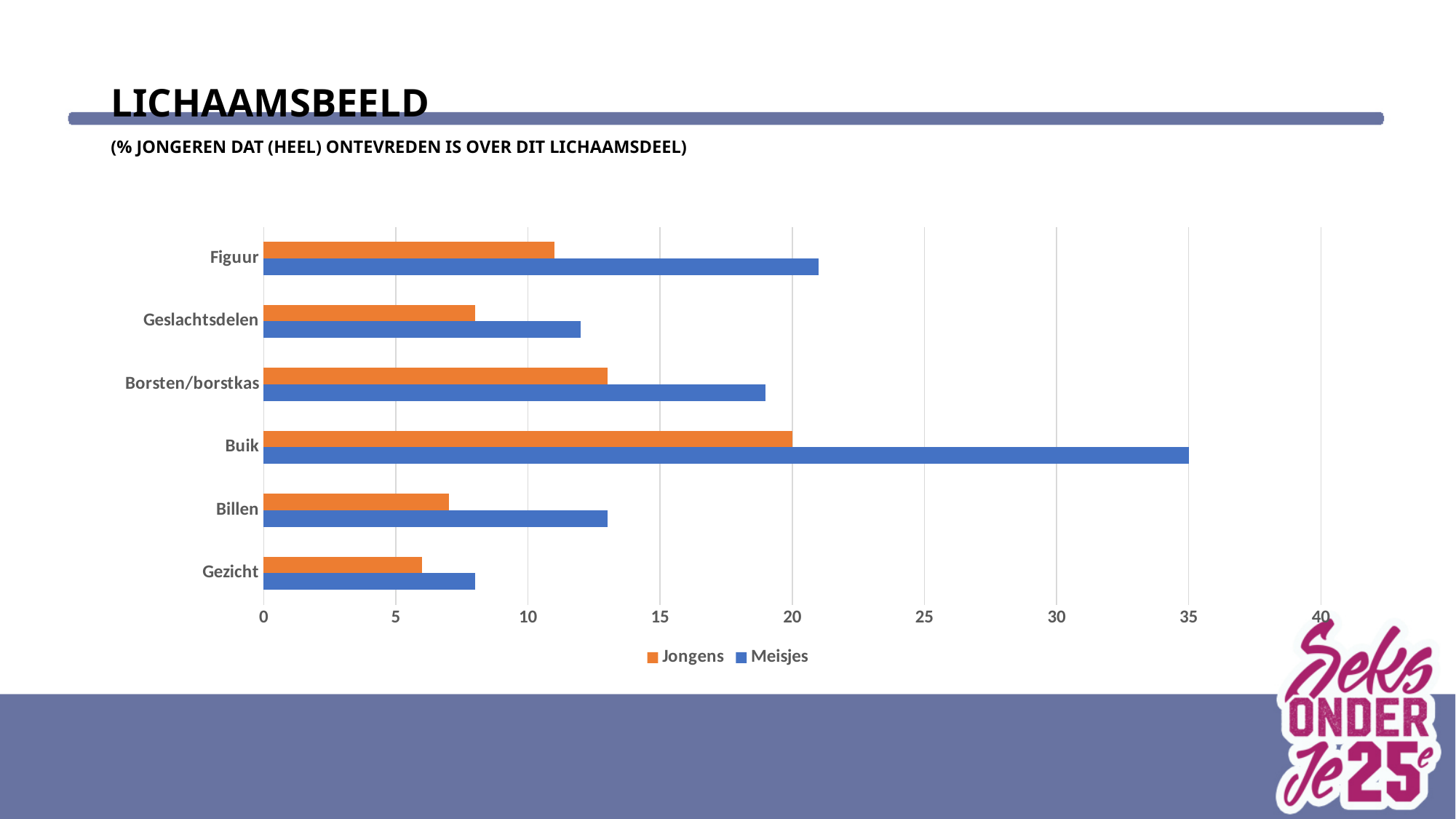
What is the value for Jongens for Buik? 20 For Borsten/borstkas, which is larger: the Jongens value or the Meisjes value? Meisjes Is the value for Jongens for Billen greater or less than 10? less Is the value for Meisjes for Borsten/borstkas greater or less than 20? less What is the difference between the Meisjes and Jongens values for Buik? 15 How many series does the legend list? 2 What type of chart is shown on the slide? bar chart Which body part has the lowest value for Meisjes? Gezicht What is the value for Meisjes for Buik? 35 How many body parts (categories) are listed on the chart? 6 Which body part has the highest value for Meisjes? Buik Which series is shown in orange in the legend? Jongens